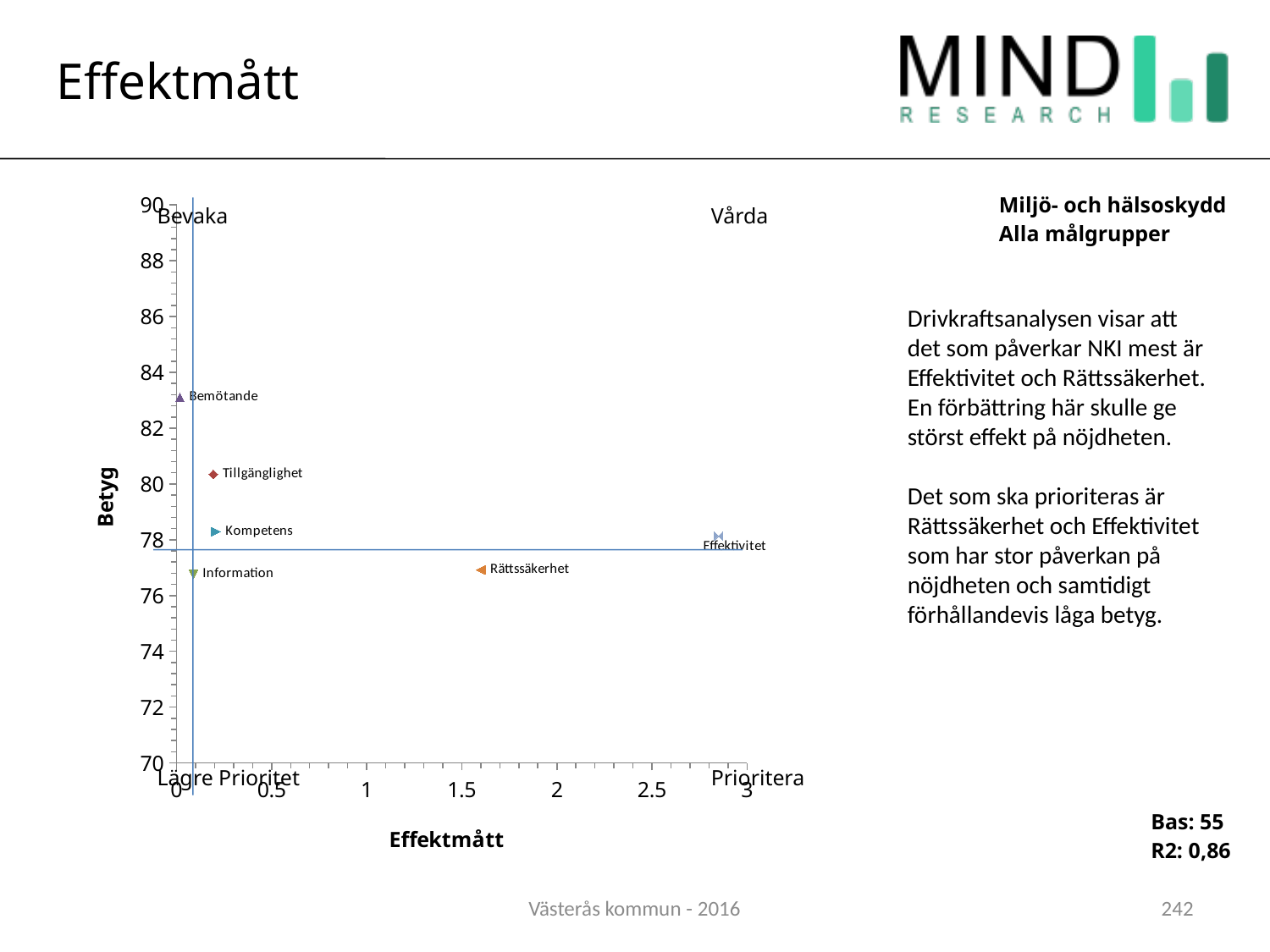
What kind of chart is shown on the slide? scatter chart Which point has the highest Betyg value? Bemötande Which has a higher Betyg value, Bemötande or Tillgänglighet? Bemötande Which has a higher Effektmått value, Effektivitet or Rättssäkerhet? Effektivitet Is the Effektmått value for Rättssäkerhet greater or less than 1? greater Is the Betyg value for Bemötande greater or less than 82? greater Is the Betyg value for Kompetens greater or less than 80? less Which point has the highest Effektmått value? Effektivitet What is the title of the vertical axis? Betyg How many data points are plotted in the chart? 6